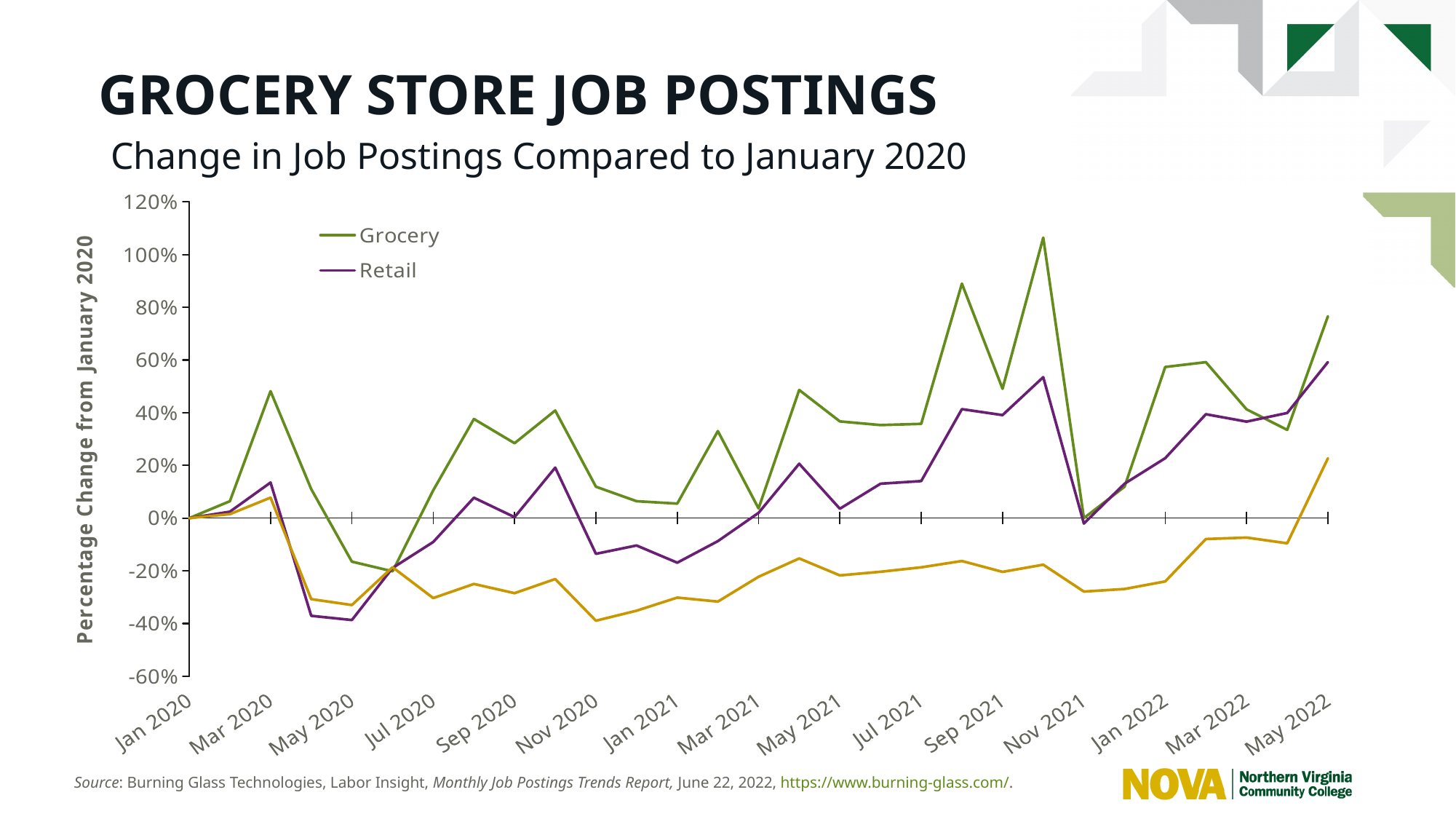
Is the Grocery value in October 2021 greater or less than 100%? greater What is the label on the vertical axis? Percentage Change from January 2020 Is the Retail value in April 2020 greater or less than -20%? less What kind of chart is shown on the slide? Line chart In which month does the Grocery line reach its highest value? October 2021 How many series does the chart's legend list? 2 Is the Retail value in October 2021 greater or less than 40%? greater Does the Grocery line rise or fall from January 2020 to March 2020? Rise Which two series are named in the legend? Grocery and Retail In September 2021, which series has the higher value, Grocery or Retail? Grocery